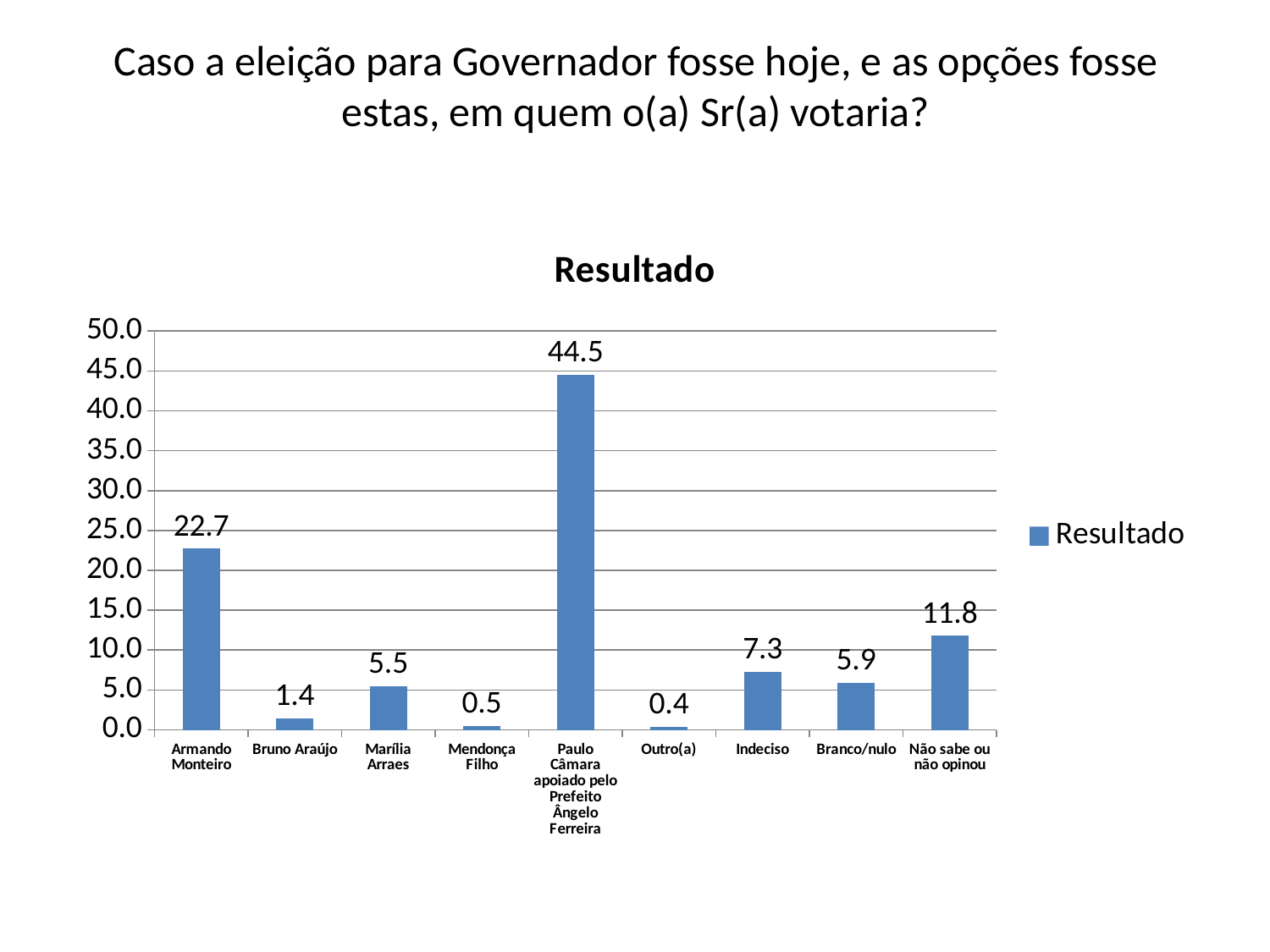
What kind of chart is shown? bar chart How many series does the legend list? 1 What is the value for Não sabe ou não opinou? 11.8 What is the value for Paulo Câmara apoiado pelo Prefeito Ângelo Ferreira? 44.5 What is the difference between the values for Paulo Câmara apoiado pelo Prefeito Ângelo Ferreira and Armando Monteiro? 21.8 Which is larger, the value for Indeciso or the value for Branco/nulo? Indeciso How many categories are shown on the x axis? 9 Which category has the lowest value? Outro(a) Which category has the highest value? Paulo Câmara apoiado pelo Prefeito Ângelo Ferreira What is the title of the chart? Resultado What is the value for Armando Monteiro? 22.7 Is the value for Marília Arraes greater or less than 10.0? less